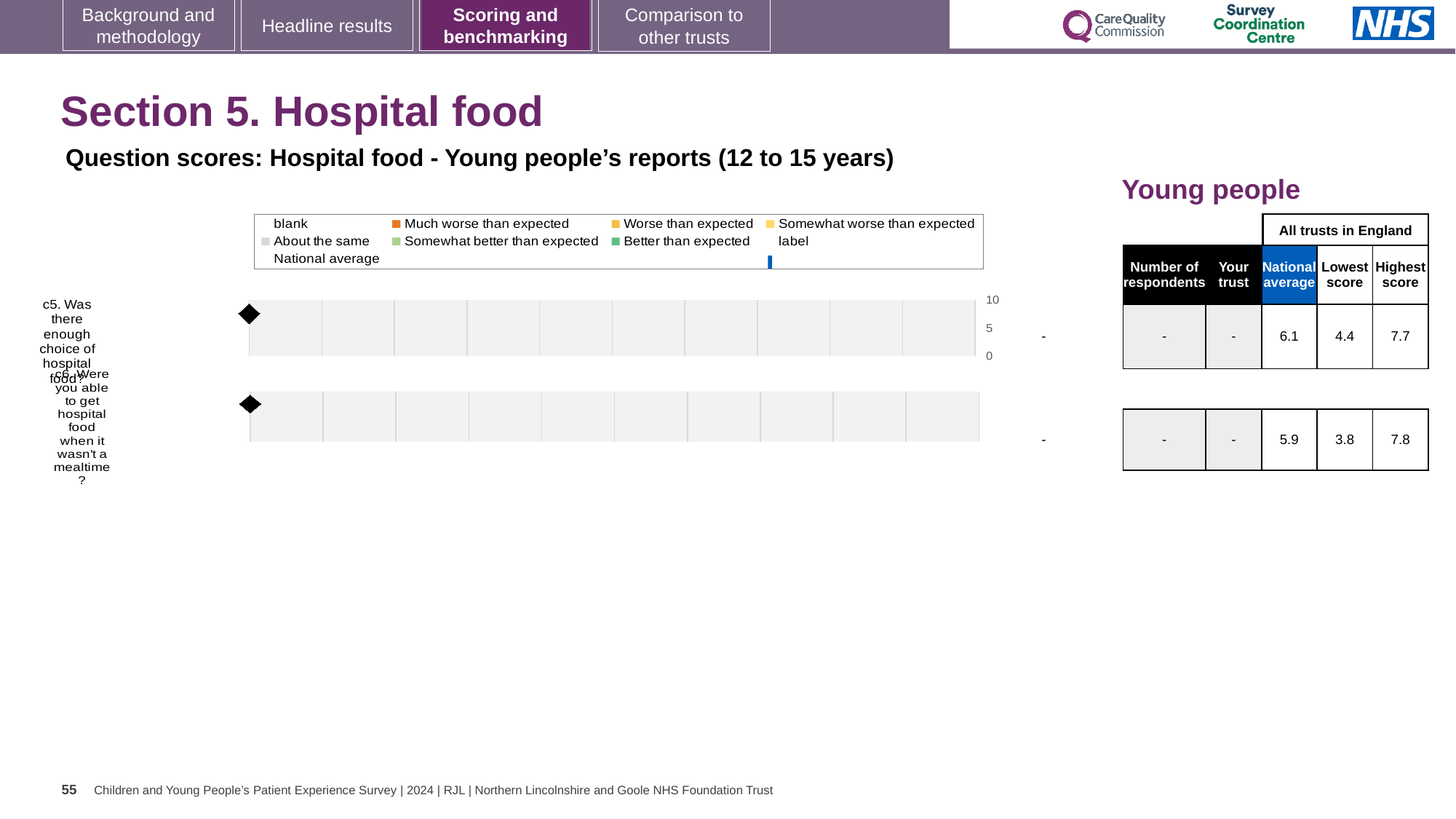
What is the highest score across all trusts in England for question c5? 7.7 Which question has the higher 'Highest score' value, c5 or c6? c6 What value is shown for 'Your trust' for question c5? - Which question has the higher national average score, c5 or c6? c5 How many questions (categories) are plotted on the chart? 2 What is the difference between the highest and lowest trust scores for question c6? 4.0 What is the highest value shown on the chart's score axis? 10 What is the lowest score across all trusts in England for question c6 (getting hospital food when it wasn't a mealtime)? 3.8 What kind of chart is shown on the slide? bar chart What is the national average score for question c5 (enough choice of hospital food)? 6.1 What is the difference between the highest and lowest trust scores for question c5? 3.3 What colour does the legend use for 'Much worse than expected'? orange